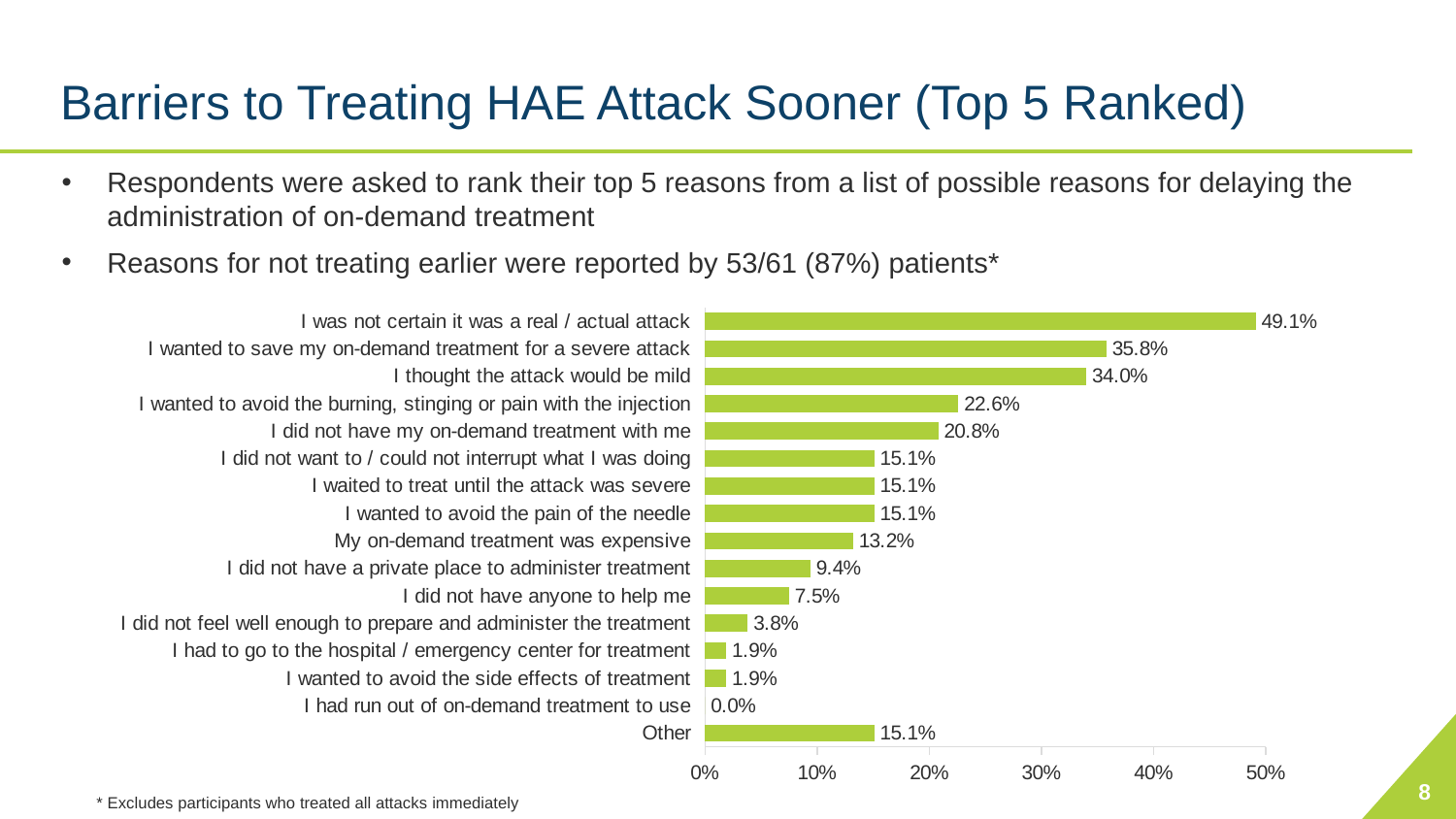
Is the value for "I wanted to avoid the burning, stinging or pain with the injection" greater or less than 20%? greater What is the value for "Other"? 15.1% Which is larger: "I did not have a private place to administer treatment" or "I did not have anyone to help me"? I did not have a private place to administer treatment What percentage is shown for "My on-demand treatment was expensive"? 13.2% What type of chart is shown on the slide? Bar chart What is the difference between "I wanted to save my on-demand treatment for a severe attack" and "I thought the attack would be mild"? 1.8% Which barrier has the highest percentage? I was not certain it was a real / actual attack What percentage of respondents reported "I was not certain it was a real / actual attack" as a barrier? 49.1% How many barrier categories are shown in the chart? 16 What is the maximum value shown on the x axis? 50% What is the value for "I thought the attack would be mild"? 34.0% Which barrier has the lowest percentage? I had run out of on-demand treatment to use